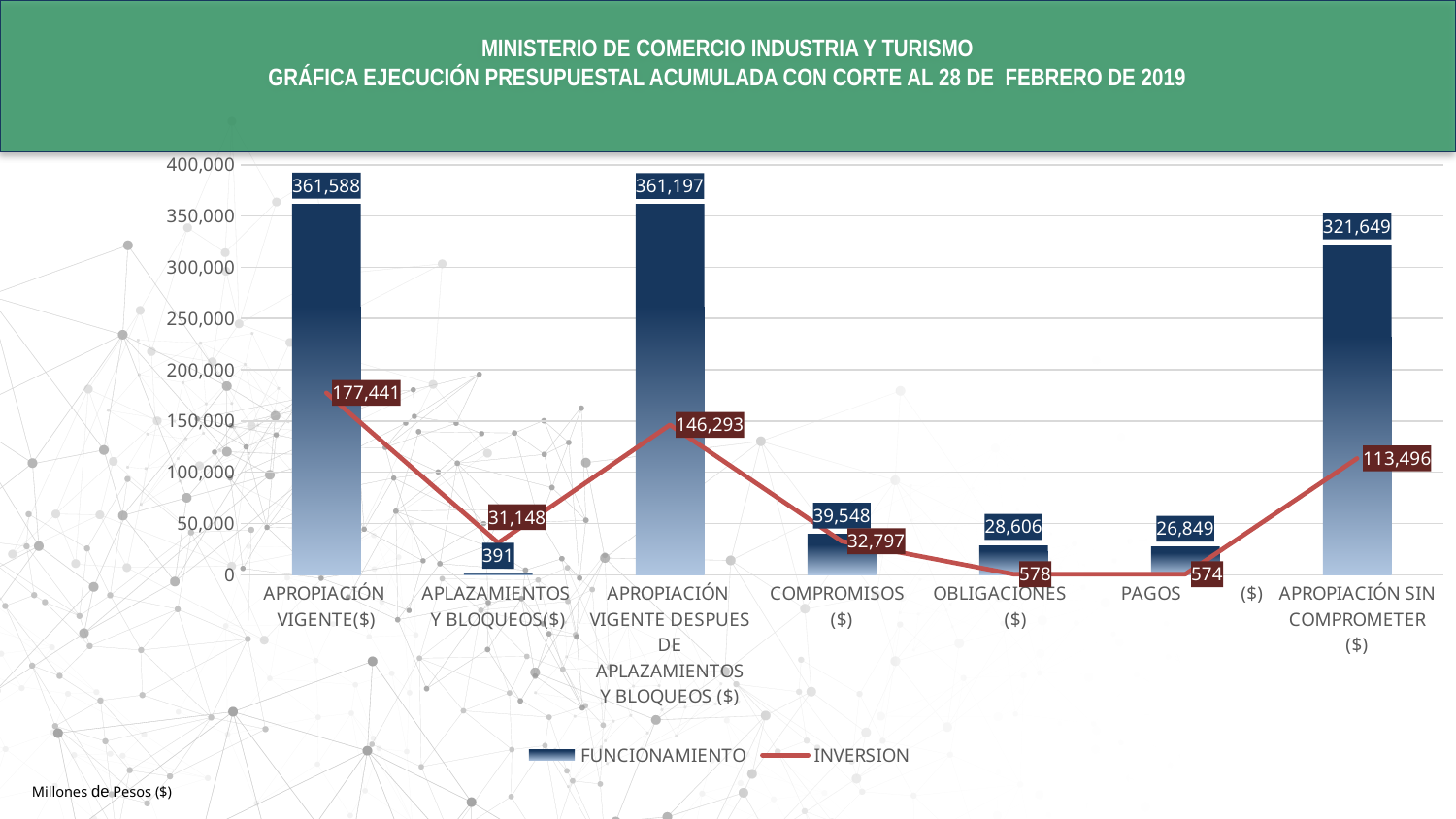
What is the INVERSION value for COMPROMISOS ($)? 32,797 Which category has the highest FUNCIONAMIENTO value? APROPIACIÓN VIGENTE($) What is the difference between the FUNCIONAMIENTO values for APROPIACIÓN VIGENTE($) and APROPIACIÓN VIGENTE DESPUES DE APLAZAMIENTOS Y BLOQUEOS ($)? 391 What is the FUNCIONAMIENTO value for APROPIACIÓN VIGENTE($)? 361,588 Which series is drawn as a red line? INVERSION Which is larger for OBLIGACIONES ($): the FUNCIONAMIENTO value or the INVERSION value? FUNCIONAMIENTO How many categories are shown on the x axis? 7 What is the INVERSION value for APROPIACIÓN VIGENTE($)? 177,441 What is the FUNCIONAMIENTO value for PAGOS ($)? 26,849 What kind of chart is this? Combined bar and line chart How many series does the legend list? 2 Which category has the lowest FUNCIONAMIENTO value? APLAZAMIENTOS Y BLOQUEOS($)